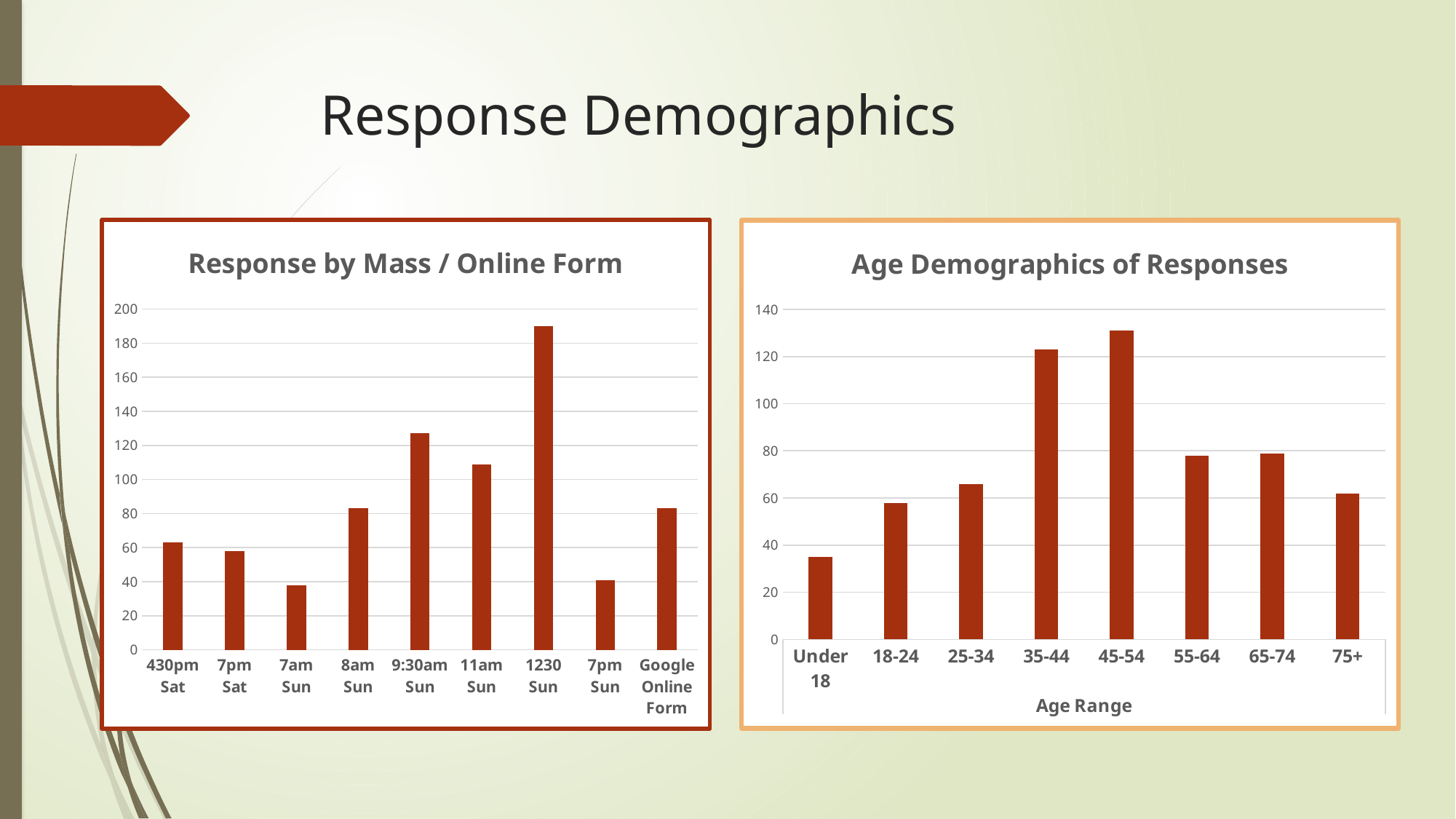
On the 'Age Demographics of Responses' chart, which is larger, the value for 35-44 or the value for 25-34? 35-44 On the 'Age Demographics of Responses' chart, how many age ranges are shown on the x axis? 8 On the 'Response by Mass / Online Form' chart, is the value for 1230 Sun greater or less than 180? greater On the 'Response by Mass / Online Form' chart, which category has the lowest value? 7am Sun What is the x-axis title of the 'Age Demographics of Responses' chart? Age Range On the 'Age Demographics of Responses' chart, which age range has the lowest value? Under 18 On the 'Response by Mass / Online Form' chart, how many categories are shown on the x axis? 9 What kind of chart is the 'Response by Mass / Online Form' chart? Bar chart On the 'Response by Mass / Online Form' chart, which category has the highest value? 1230 Sun On the 'Response by Mass / Online Form' chart, is the value for 11am Sun greater or less than 100? greater On the 'Response by Mass / Online Form' chart, which is larger, the value for 9:30am Sun or the value for 11am Sun? 9:30am Sun